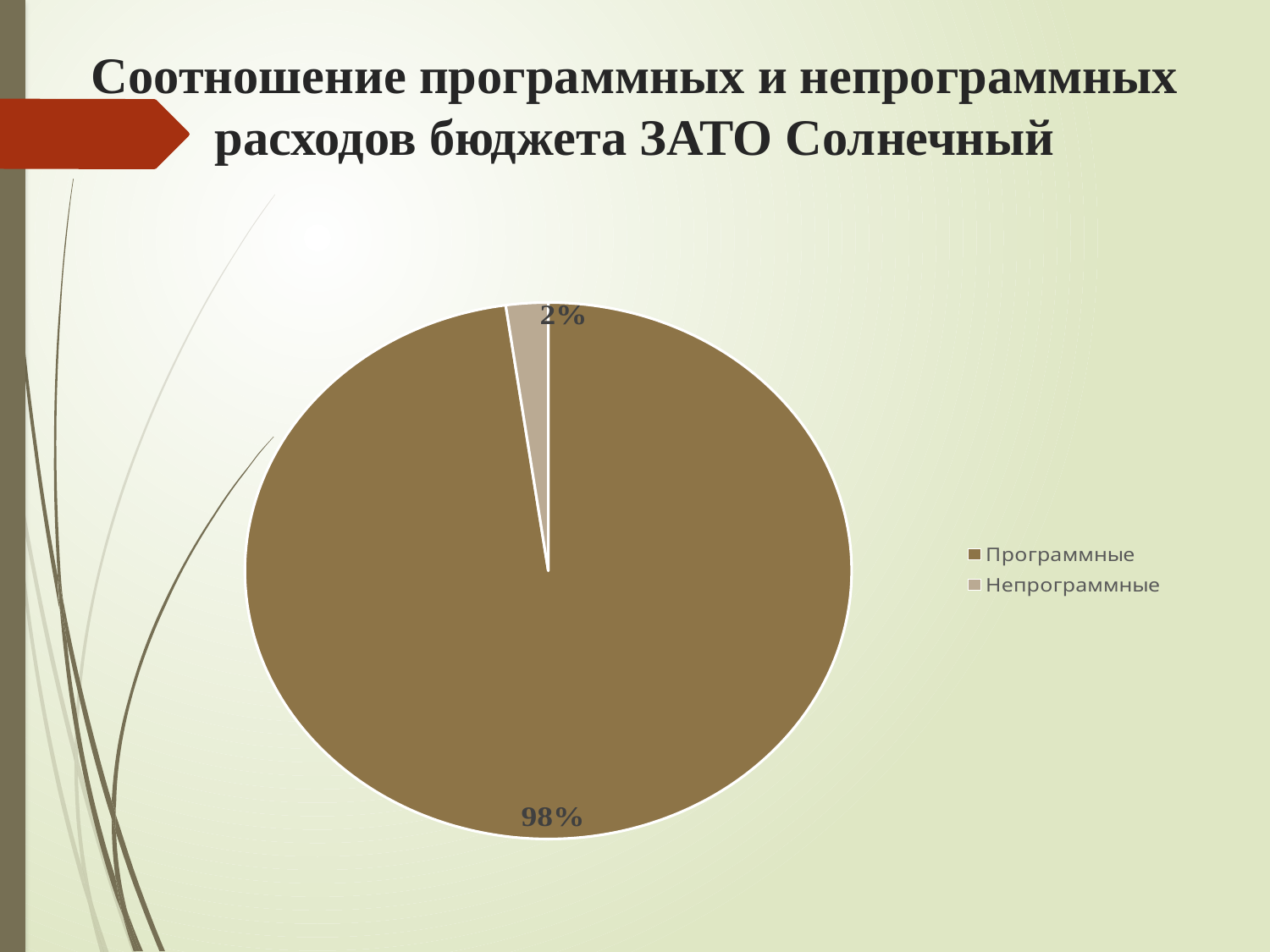
How many slices does the pie chart have? 2 What kind of chart is shown on the slide? pie chart How many entries does the legend list? 2 What share of the pie does Программные take? 98% Which legend entry is listed first? Программные What is the title of the slide containing the chart? Соотношение программных и непрограммных расходов бюджета ЗАТО Солнечный Which is larger, the slice for Программные or the slice for Непрограммные? Программные What is the difference in percentage points between the Программные and Непрограммные slices? 96 Which category has the largest slice of the pie? Программные What share of the pie does Непрограммные take? 2% Which category has the smallest slice of the pie? Непрограммные